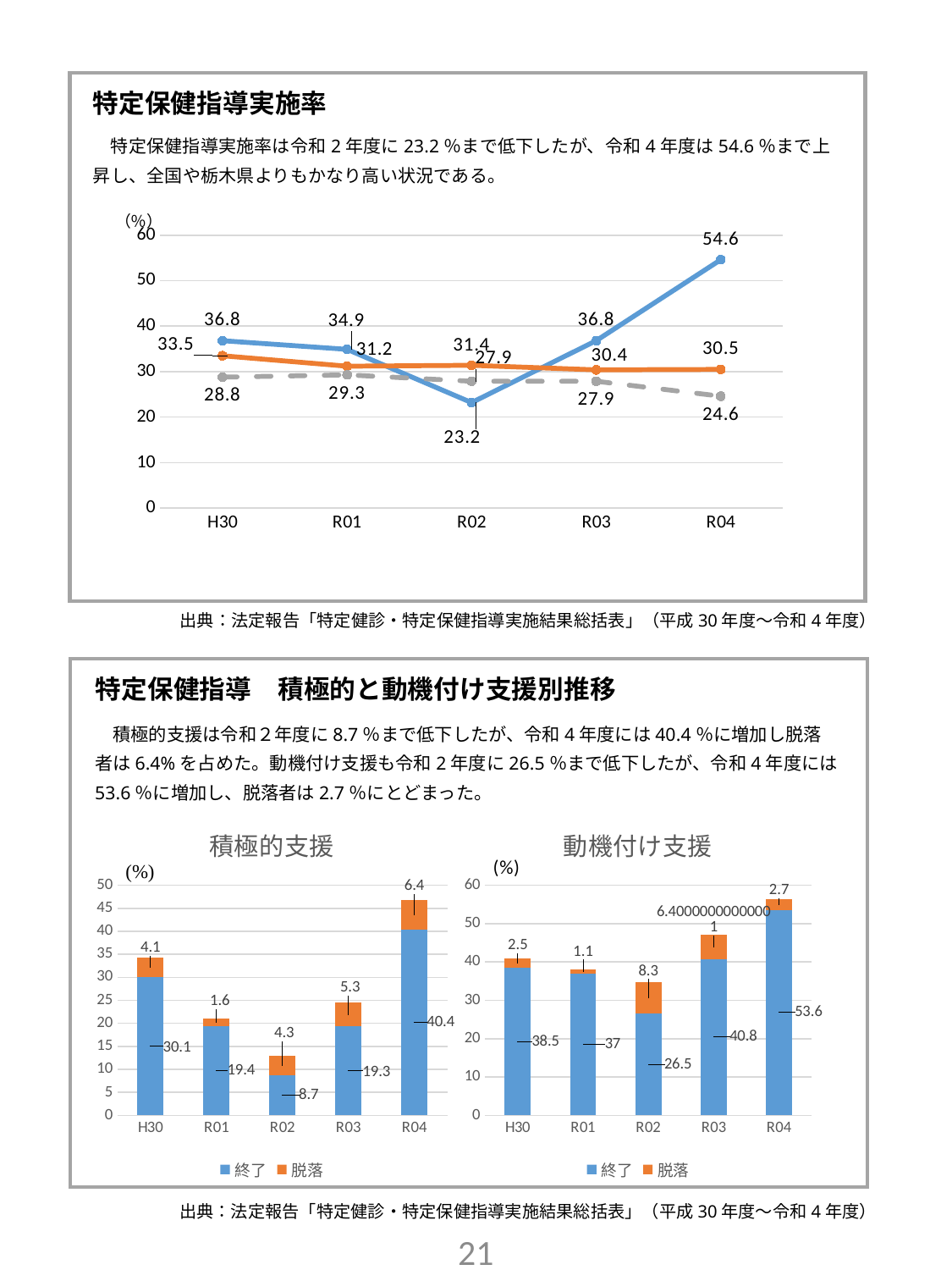
In the 積極的支援 chart, which year has the lowest 終了 value? R02 In the top line chart (特定保健指導実施率), what is the value of the gray dashed line at R04? 24.6 In the 動機付け支援 chart, what is the 脱落 value for R02? 8.3 In the 積極的支援 chart, what is the total of the stacked bar for R02? 13.0 How many series does the legend of the 動機付け支援 chart list? 2 In the top line chart (特定保健指導実施率), what is the difference between the blue line and the orange line at R04? 24.1 In the top line chart (特定保健指導実施率), at which year does the blue line reach its lowest value? R02 In the 積極的支援 chart, what is the 終了 value for R04? 40.4 What kind of chart is the top chart (特定保健指導実施率)? Line chart In the 動機付け支援 chart, what is the total of the stacked bar for R04? 56.3 In the top line chart (特定保健指導実施率), how many years are shown on the x axis? 5 In the top line chart (特定保健指導実施率), what is the value of the blue line at R04? 54.6